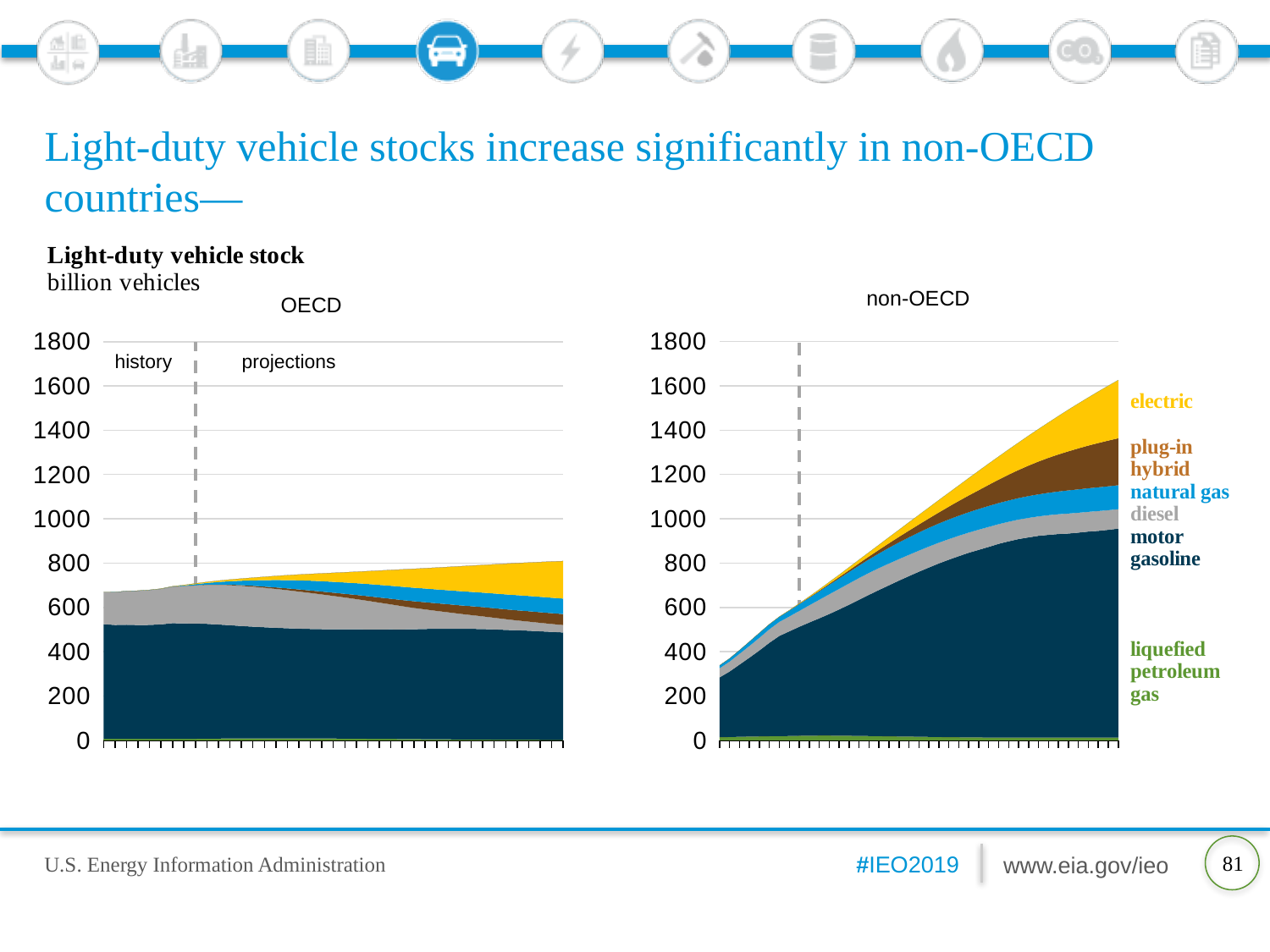
On the non-OECD chart, does the total light-duty vehicle stock rise or fall over the projection period? rise What kind of chart is the OECD chart? stacked area chart How many vehicle fuel types are labelled on the non-OECD chart? 6 On the OECD chart, does the electric vehicle stock rise or fall over the projection period? rise On the non-OECD chart, which fuel type is shown in yellow at the top of the stack? electric What unit is the light-duty vehicle stock measured in on these charts? billion vehicles On the OECD chart, is the motor gasoline stock at the end of the projection period greater or less than 600? less Which chart shows the larger total light-duty vehicle stock at the end of the projection period, OECD or non-OECD? non-OECD On the non-OECD chart, is the total light-duty vehicle stock at the start of the history period greater or less than 400? less On the OECD chart, is the total light-duty vehicle stock at the start of the history period greater or less than 800? less